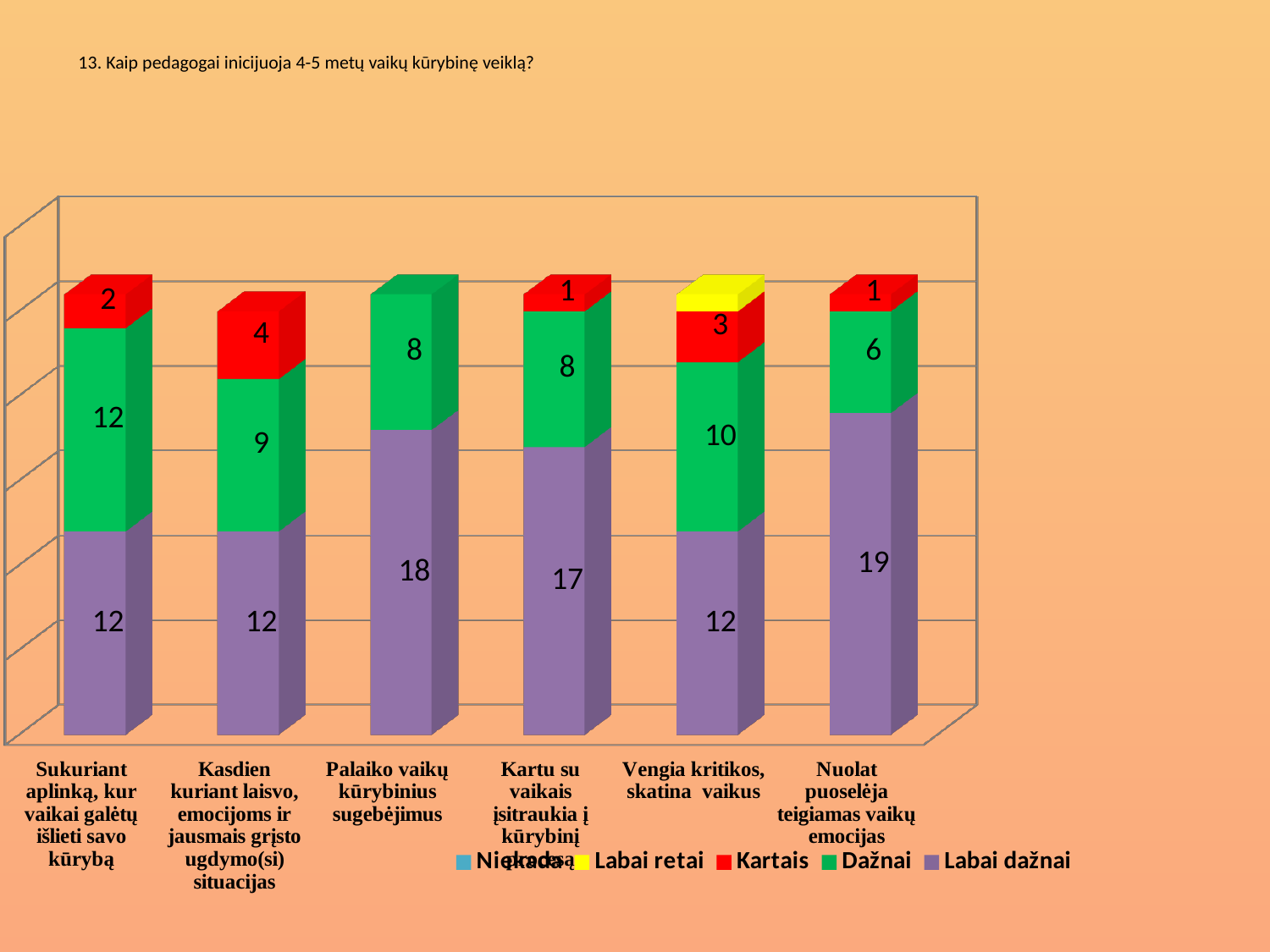
What colour represents 'Kartais' in the legend? red Which category has the highest 'Labai dažnai' value? Nuolat puoselėja teigiamas vaikų emocijas How many categories are shown along the x axis? 6 How many series does the legend list? 5 What is the total of the stacked bar for 'Kasdien kuriant laisvo, emocijoms ir jausmais grįsto ugdymo(si) situacijas'? 25 Which has the larger 'Kartais' value: 'Kasdien kuriant laisvo, emocijoms ir jausmais grįsto ugdymo(si) situacijas' or 'Sukuriant aplinką, kur vaikai galėtų išlieti savo kūrybą'? Kasdien kuriant laisvo, emocijoms ir jausmais grįsto ugdymo(si) situacijas What kind of chart is shown on the slide? stacked bar chart For 'Palaiko vaikų kūrybinius sugebėjimus', what is the difference between the 'Labai dažnai' and 'Dažnai' values? 10 What is the value of 'Kartais' for 'Kasdien kuriant laisvo, emocijoms ir jausmais grįsto ugdymo(si) situacijas'? 4 What is the value of 'Dažnai' for 'Vengia kritikos, skatina vaikus'? 10 Which category has the lowest 'Dažnai' value? Nuolat puoselėja teigiamas vaikų emocijas What is the value of 'Labai dažnai' for 'Nuolat puoselėja teigiamas vaikų emocijas'? 19